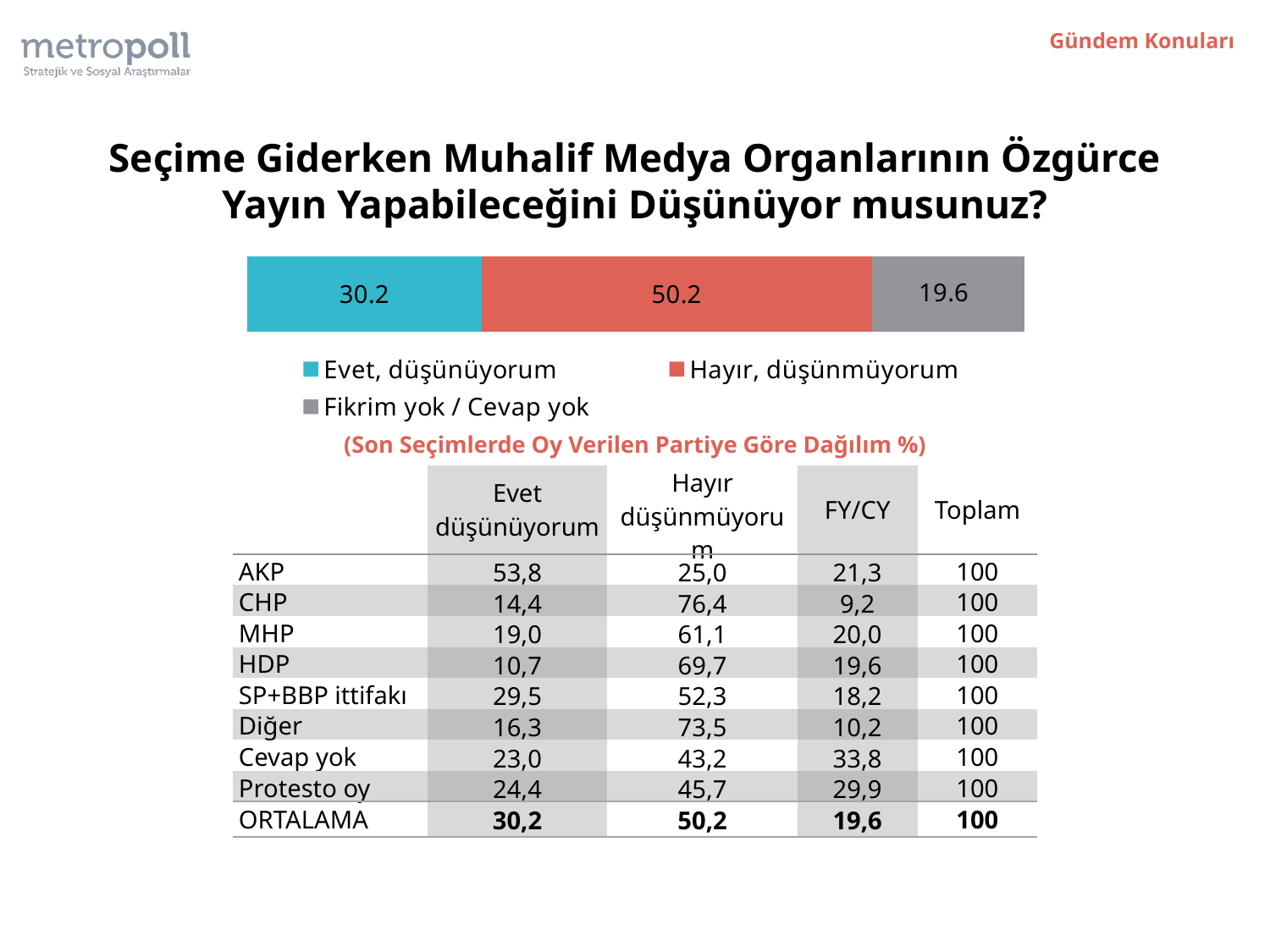
Which legend category has the largest segment in the stacked bar? Hayır, düşünmüyorum What value is shown for the "Fikrim yok / Cevap yok" segment of the stacked bar? 19.6 What value is shown for the "Evet, düşünüyorum" segment of the stacked bar? 30.2 What is the difference between the "Hayır, düşünmüyorum" and "Evet, düşünüyorum" values in the stacked bar? 20.0 What kind of chart is shown on the slide? Stacked bar chart Which is larger in the stacked bar: "Evet, düşünüyorum" or "Fikrim yok / Cevap yok"? Evet, düşünüyorum How many series does the chart legend list? 3 What is the total of the three segments in the stacked bar? 100 Which legend category has the smallest segment in the stacked bar? Fikrim yok / Cevap yok What value is shown for the "Hayır, düşünmüyorum" segment of the stacked bar? 50.2 What colour is the "Hayır, düşünmüyorum" segment in the stacked bar? Red What colour is the "Evet, düşünüyorum" segment in the stacked bar? Teal/blue